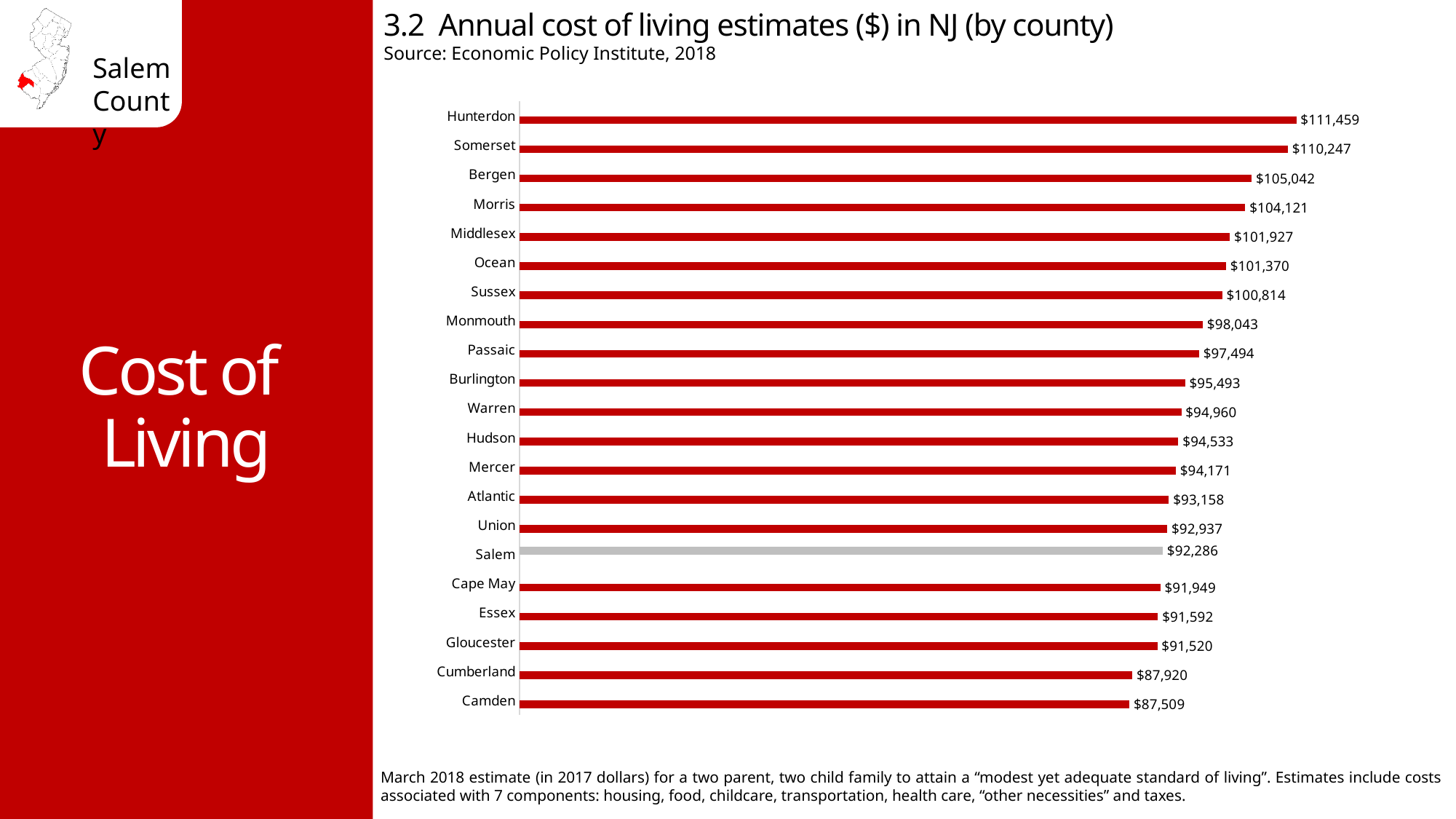
Which county has the lowest annual cost of living estimate? Camden Which county's bar is shown in grey rather than red? Salem Which county has a higher cost of living estimate, Morris or Monmouth? Morris Which county has the highest annual cost of living estimate? Hunterdon What is the annual cost of living estimate for Salem County? $92,286 What is the source of the data shown in the chart? Economic Policy Institute, 2018 Which county has a higher cost of living estimate, Gloucester or Cumberland? Gloucester What kind of chart is used to show the cost of living estimates? Bar chart What is the difference between the cost of living estimates for Hunterdon and Camden? $23,950 What is the difference between the cost of living estimates for Salem and Cumberland? $4,366 How many counties are shown in the chart? 21 What is the annual cost of living estimate for Bergen County? $105,042